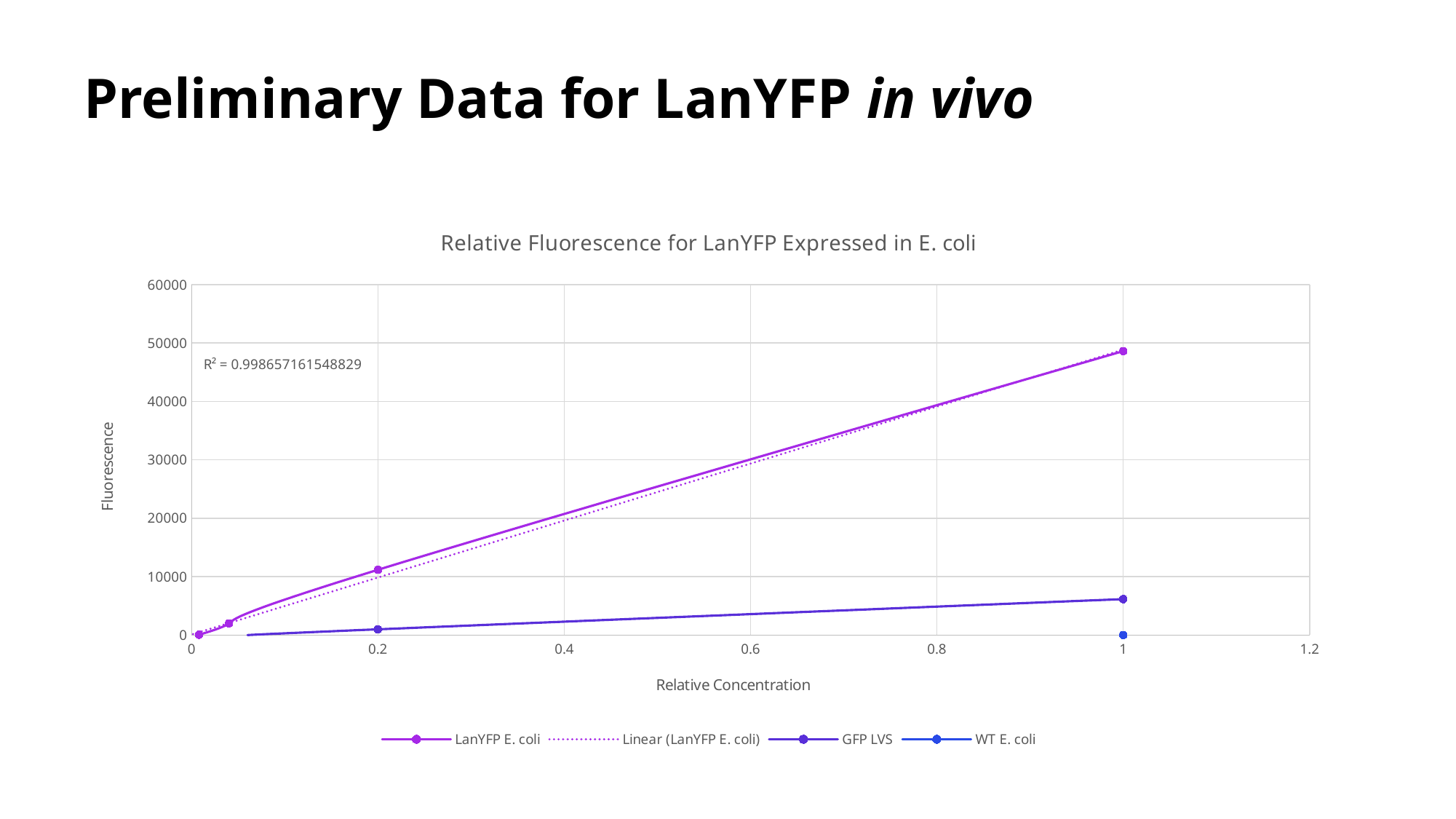
Which series has the highest fluorescence at relative concentration 1? LanYFP E. coli Is the fluorescence for LanYFP E. coli at relative concentration 1 greater or less than 40000? greater Which series has the lowest fluorescence at relative concentration 1? WT E. coli What is the R² value shown on the chart? R² = 0.998657161548829 Does the fluorescence for LanYFP E. coli rise or fall as relative concentration increases? rise What is the title of the chart? Relative Fluorescence for LanYFP Expressed in E. coli Is the fluorescence for LanYFP E. coli at relative concentration 0.2 greater or less than 20000? less At relative concentration 1, which is larger: the fluorescence for LanYFP E. coli or for GFP LVS? LanYFP E. coli What is the label of the y axis? Fluorescence How many entries does the chart legend list? 4 Is the fluorescence for GFP LVS at relative concentration 1 greater or less than 10000? less